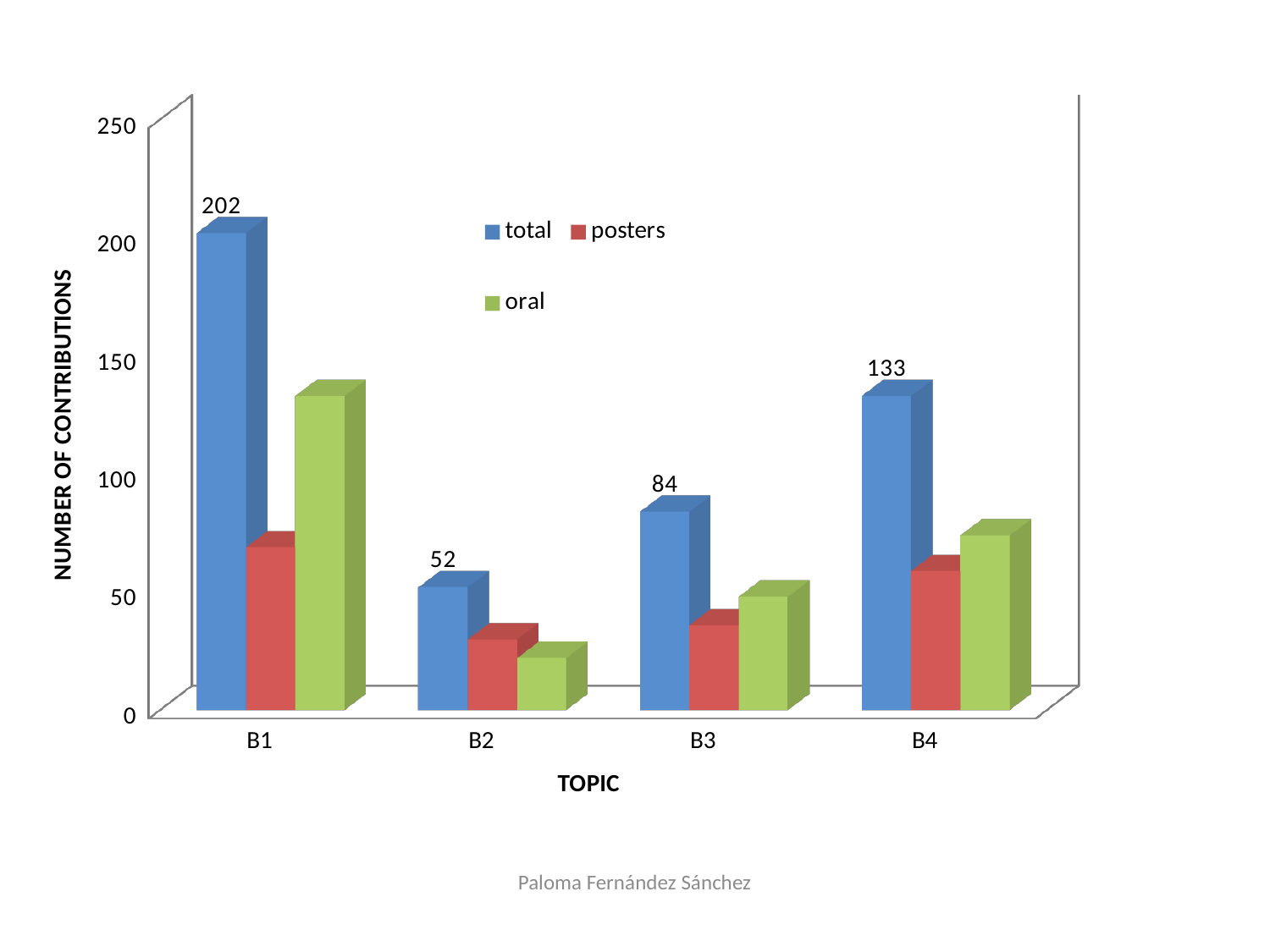
What is the total number of contributions for topic B4? 133 Is the oral value for B2 greater or less than 50? less Which topic has the highest total number of contributions? B1 Which topic has the lowest total number of contributions? B2 What is the total number of contributions for topic B3? 84 What kind of chart is shown on the slide? bar chart What is the difference between the total contributions for B3 and B2? 32 What is the total number of contributions for topic B1? 202 Is the oral value for B1 greater or less than 100? greater What is the difference between the total contributions for B1 and B4? 69 Which has a larger total number of contributions, B3 or B4? B4 How many series does the legend list? 3